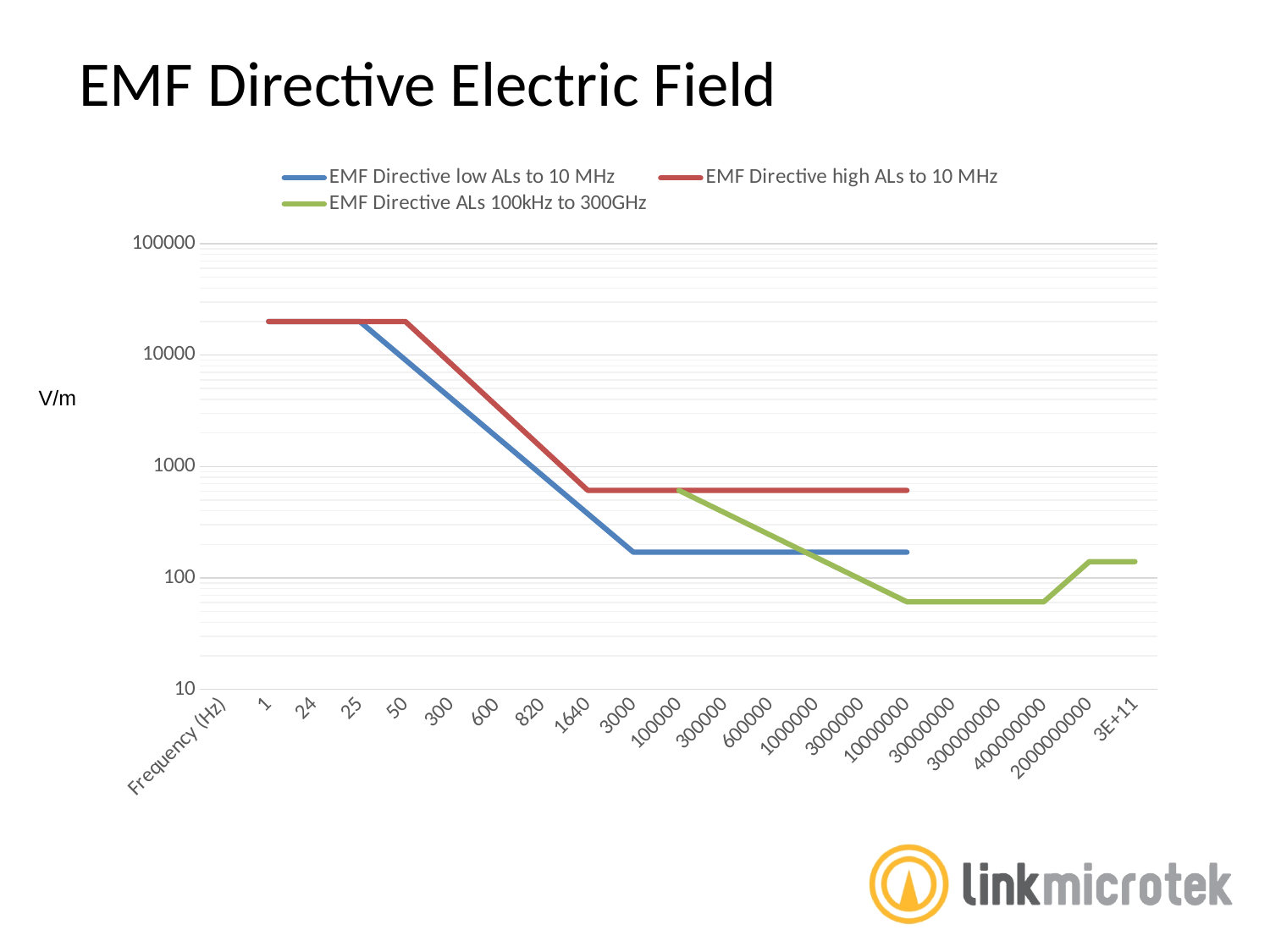
At frequency 10000000, which series has the higher value: EMF Directive low ALs to 10 MHz or EMF Directive ALs 100kHz to 300GHz? EMF Directive low ALs to 10 MHz How many frequency categories are shown on the x axis? 20 Is the value of the EMF Directive ALs 100kHz to 300GHz series at frequency 3E+11 greater or less than 100? greater At frequency 3000, which series has the higher value: EMF Directive low ALs to 10 MHz or EMF Directive high ALs to 10 MHz? EMF Directive high ALs to 10 MHz Is the value of the EMF Directive low ALs to 10 MHz series at frequency 3000 greater or less than 1000? less Is the value of the EMF Directive high ALs to 10 MHz series at frequency 1640 greater or less than 1000? less Does the EMF Directive low ALs to 10 MHz series rise or fall between frequency 25 and frequency 3000? fall What kind of chart is shown on the slide? Line chart What is the label on the vertical axis of the chart? V/m How many series does the legend list? 3